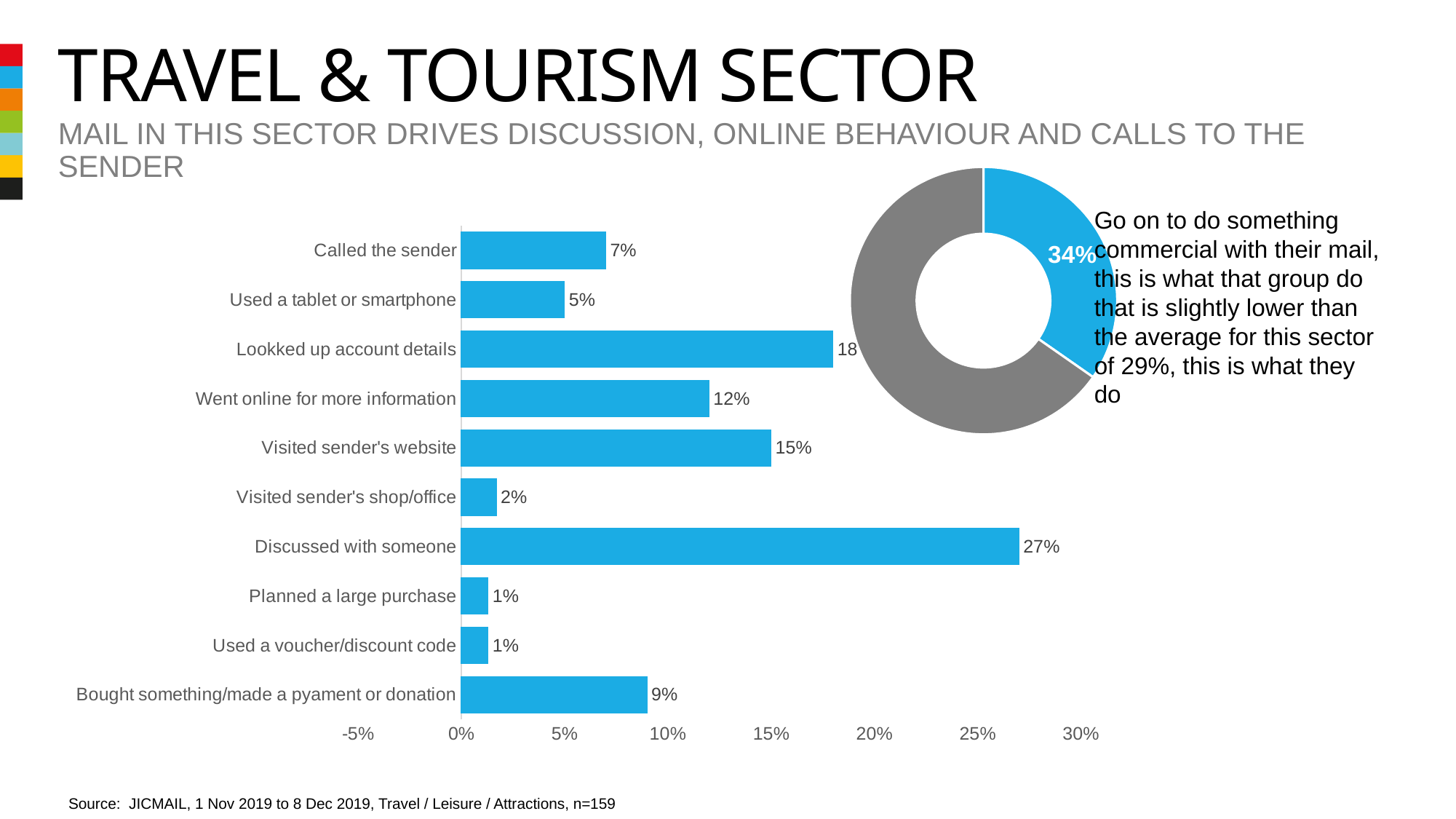
In the bar chart, is the value for 'Lookked up account details' greater or less than 15%? greater What kind of chart is the chart on the right of the slide? donut chart What kind of chart is the chart on the left of the slide? bar chart In the donut chart, what share does the blue slice represent? 34% In the bar chart, what percentage is shown for 'Visited sender's website'? 15% In the bar chart, which category has the highest value? Discussed with someone In the bar chart, which is larger: 'Called the sender' or 'Used a tablet or smartphone'? Called the sender How many categories are shown in the bar chart? 10 In the bar chart, what percentage is shown for 'Bought something/made a pyament or donation'? 9% In the bar chart, what is the difference between 'Visited sender's website' and 'Visited sender's shop/office'? 13% In the bar chart, what is the difference between 'Discussed with someone' and 'Went online for more information'? 15% In the bar chart, what percentage is shown for 'Discussed with someone'? 27%